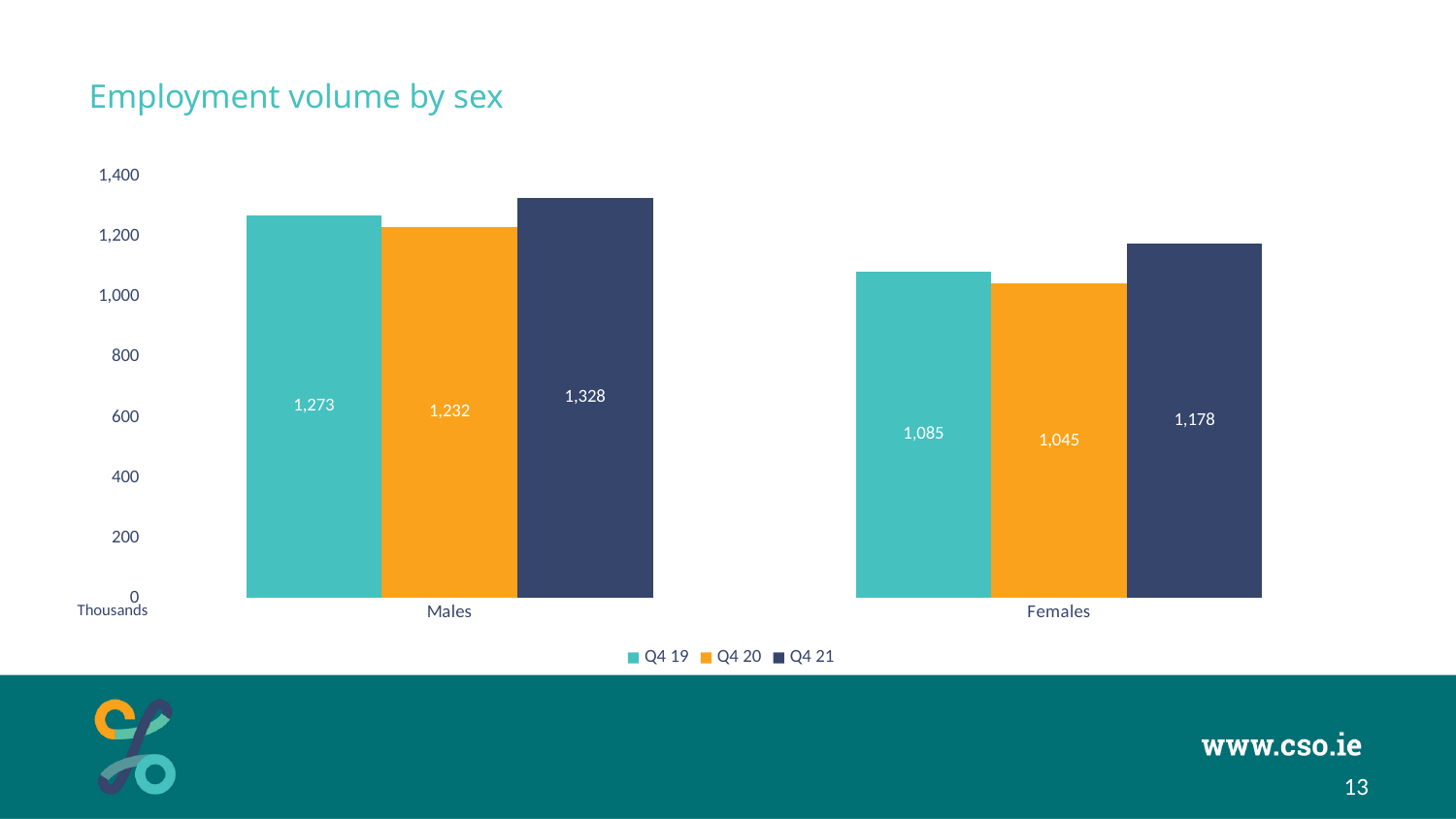
What is the employment volume for Females in Q4 20? 1,045 What is the employment volume for Males in Q4 21? 1,328 By how much did the Males employment volume change from Q4 20 to Q4 21? 96 What is the employment volume for Females in Q4 19? 1,085 How many series does the legend list? 3 What kind of chart is shown on the slide? Bar chart Is the Q4 21 value for Females greater or less than 1,200? less What is the difference between the Males and Females employment volumes in Q4 21? 150 What unit is the vertical axis measured in? Thousands Which quarter has the highest employment volume for Males? Q4 21 Which quarter has the lowest employment volume for Females? Q4 20 Which is larger, the Q4 19 value for Males or the Q4 19 value for Females? Males